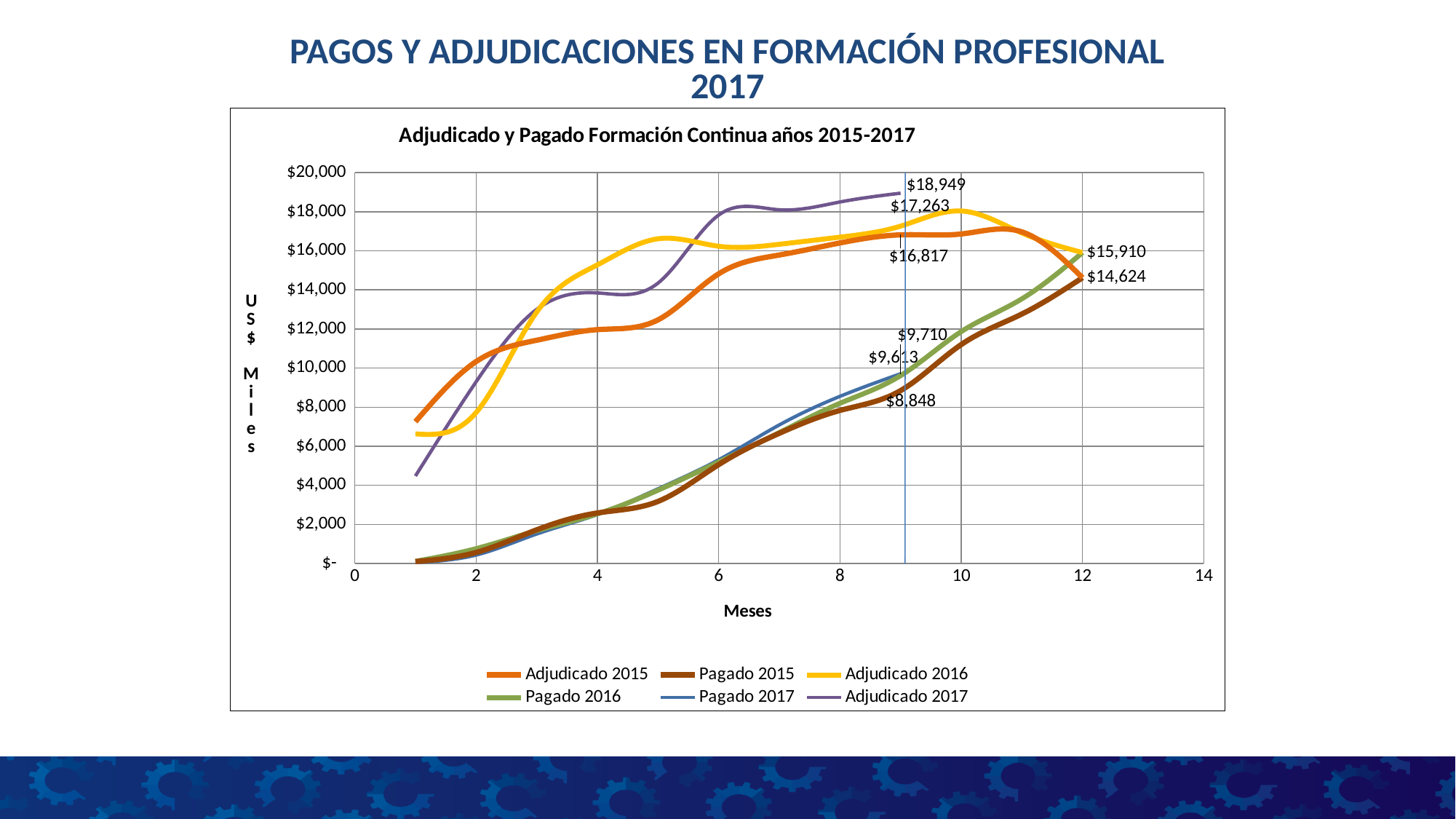
How many series does the legend list? 6 Is the value for Adjudicado 2017 at month 1 greater or less than $6,000? less What is the label of the x axis? Meses What is the value labelled for Adjudicado 2017 at month 9? $18,949 What is the value labelled for Pagado 2015 at month 9? $8,848 What is the value labelled for Pagado 2017 at month 9? $9,710 Which series has the lowest value at month 9? Pagado 2015 What type of chart is shown on the slide? Line chart What is the difference between the labelled values $18,949 and $17,263 at month 9? $1,686 Which series has the highest value at month 9? Adjudicado 2017 Does the Pagado 2016 line rise or fall from month 1 to month 12? Rises What is the title of the chart? Adjudicado y Pagado Formación Continua años 2015-2017